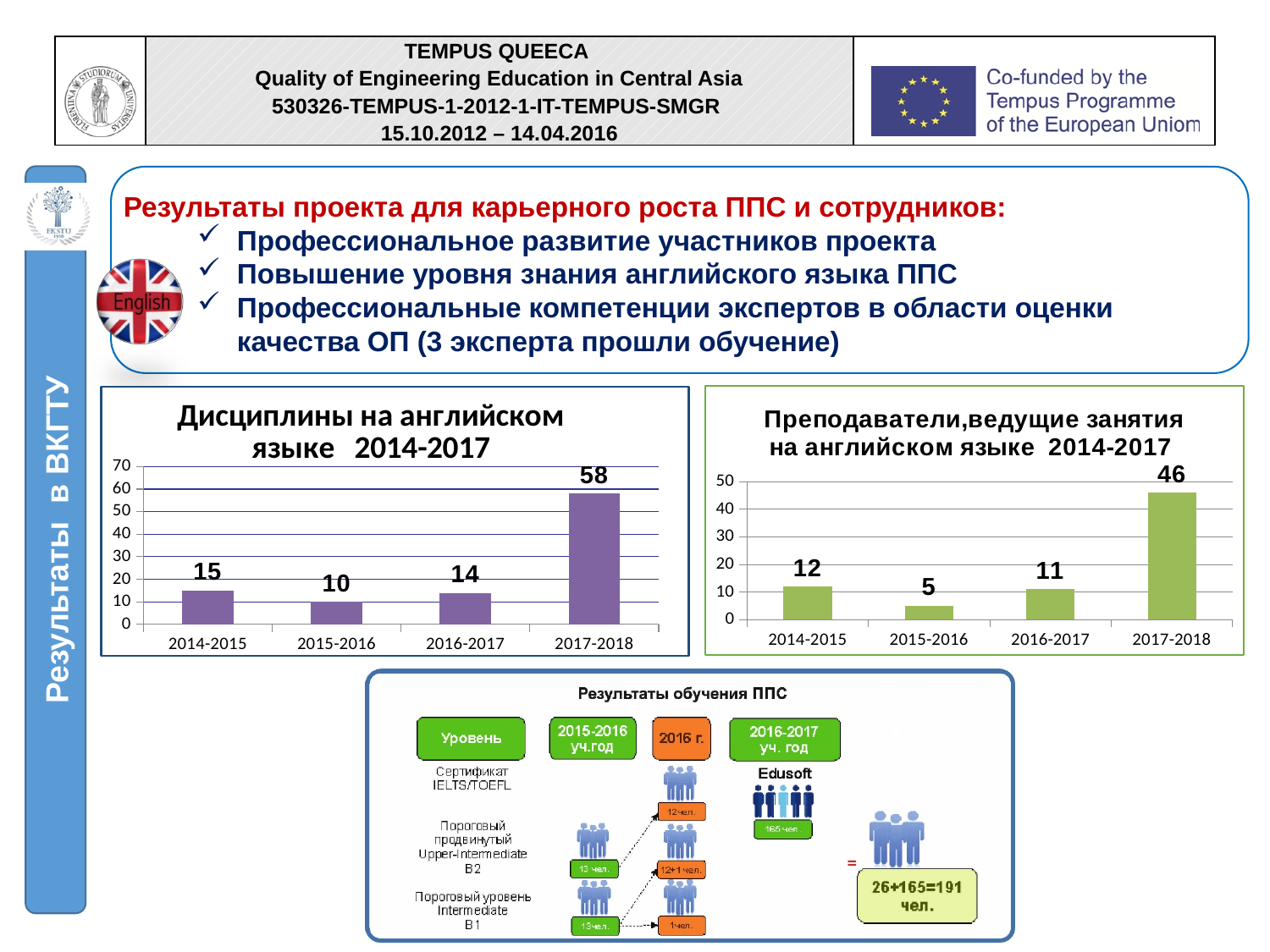
In the chart 'Преподаватели,ведущие занятия на английском языке 2014-2017', what is the value for 2016-2017? 11 In the chart 'Дисциплины на английском языке 2014-2017', what is the value for 2017-2018? 58 In the chart 'Преподаватели,ведущие занятия на английском языке 2014-2017', what is the difference between the values for 2017-2018 and 2014-2015? 34 In the chart 'Преподаватели,ведущие занятия на английском языке 2014-2017', what is the value for 2015-2016? 5 In the chart 'Дисциплины на английском языке 2014-2017', what colour are the bars? purple In the chart 'Дисциплины на английском языке 2014-2017', how many categories are shown on the x axis? 4 In the chart 'Преподаватели,ведущие занятия на английском языке 2014-2017', which category has the highest value? 2017-2018 In the chart 'Преподаватели,ведущие занятия на английском языке 2014-2017', is the value for 2017-2018 greater or less than 40? greater In the chart 'Дисциплины на английском языке 2014-2017', what is the difference between the values for 2017-2018 and 2016-2017? 44 In the chart 'Дисциплины на английском языке 2014-2017', which category has the lowest value? 2015-2016 What kind of chart is 'Дисциплины на английском языке 2014-2017'? bar chart In the chart 'Преподаватели,ведущие занятия на английском языке 2014-2017', which is larger, the value for 2014-2015 or 2016-2017? 2014-2015